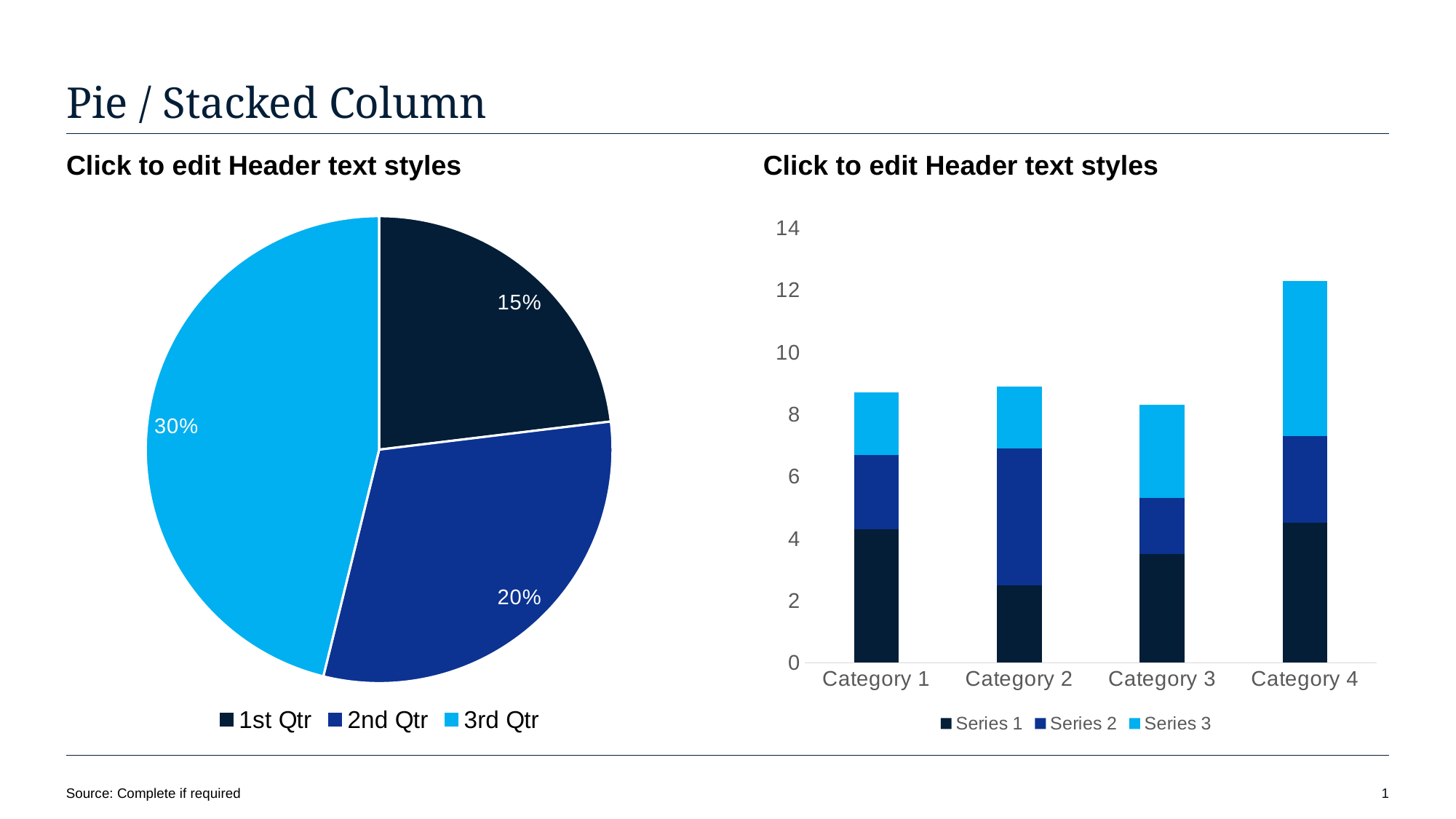
How many categories are shown on the x axis of the stacked bar chart on the right? 4 What kind of chart is the chart on the right of the slide? Bar chart In the pie chart on the left, which quarter has the smallest slice? 1st Qtr In the pie chart on the left, what percentage is shown for 3rd Qtr? 30% In the stacked bar chart on the right, is the total for Category 4 greater or less than 10? greater In the pie chart on the left, which quarter has the largest slice? 3rd Qtr How many series does the legend of the stacked bar chart on the right list? 3 What kind of chart is the chart on the left of the slide? Pie chart In the pie chart on the left, what percentage is shown for 2nd Qtr? 20% In the stacked bar chart on the right, which category has the tallest stacked bar? Category 4 In the pie chart on the left, what percentage is shown for 1st Qtr? 15% In the pie chart on the left, how many percentage points larger is the 3rd Qtr label than the 1st Qtr label? 15 percentage points